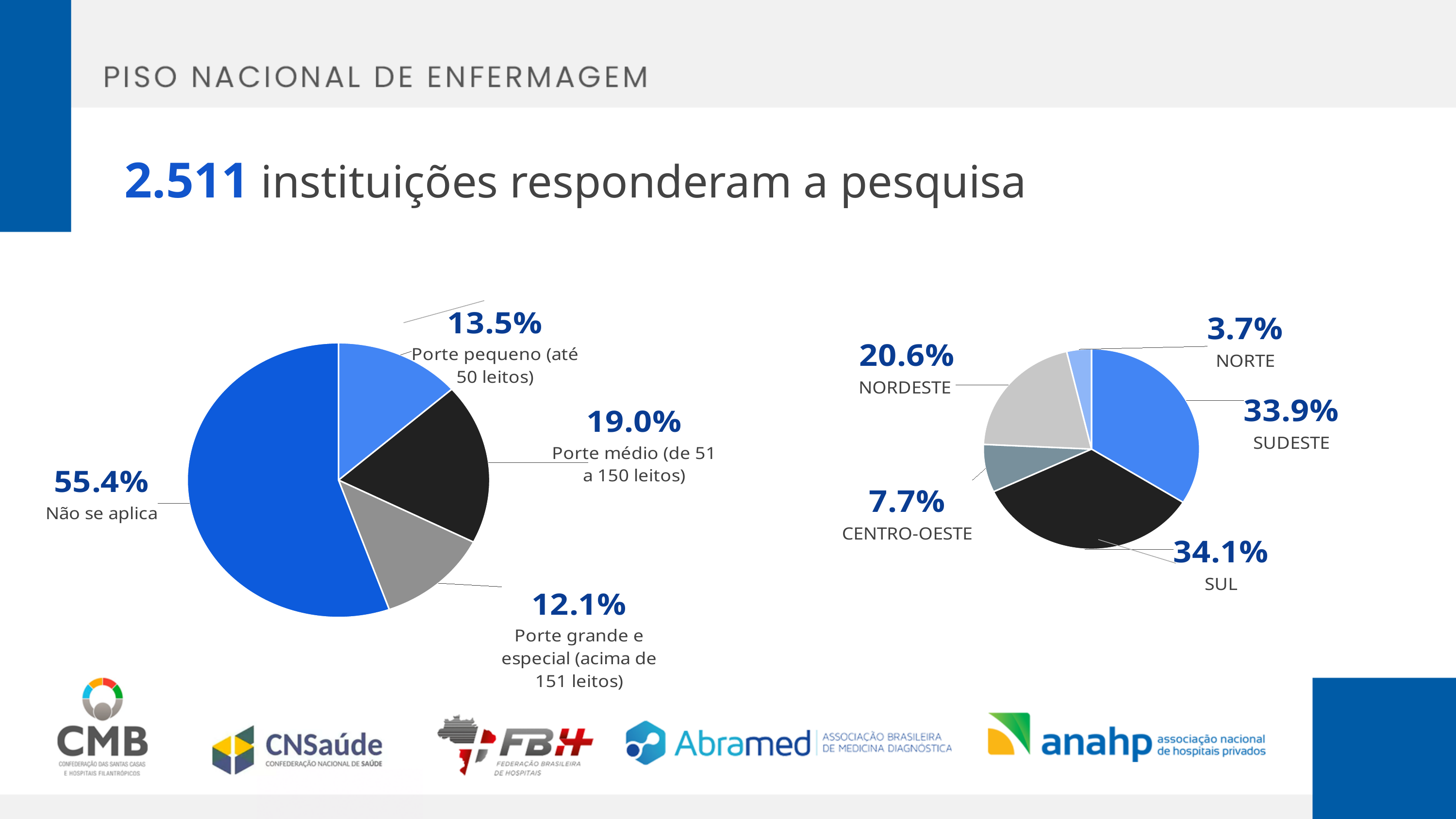
In the pie chart on the left, what is the difference between Porte médio (de 51 a 150 leitos) and Porte pequeno (até 50 leitos)? 5.5% In the pie chart on the left, what is the value for Não se aplica? 55.4% In the pie chart on the right, what is the difference between NORDESTE and CENTRO-OESTE? 12.9% In the pie chart on the left, which category has the smallest slice? Porte grande e especial (acima de 151 leitos) In the pie chart on the left, which category has the largest slice? Não se aplica In the pie chart on the right, which is larger, NORDESTE or CENTRO-OESTE? NORDESTE In the pie chart on the right, which region has the smallest slice? NORTE In the pie chart on the left, what is the value for Porte médio (de 51 a 150 leitos)? 19.0% In the pie chart on the right, what is the value for CENTRO-OESTE? 7.7% How many slices does the pie chart on the right have? 5 In the pie chart on the right, what is the value for NORDESTE? 20.6% What type of chart is shown on the left of the slide? Pie chart